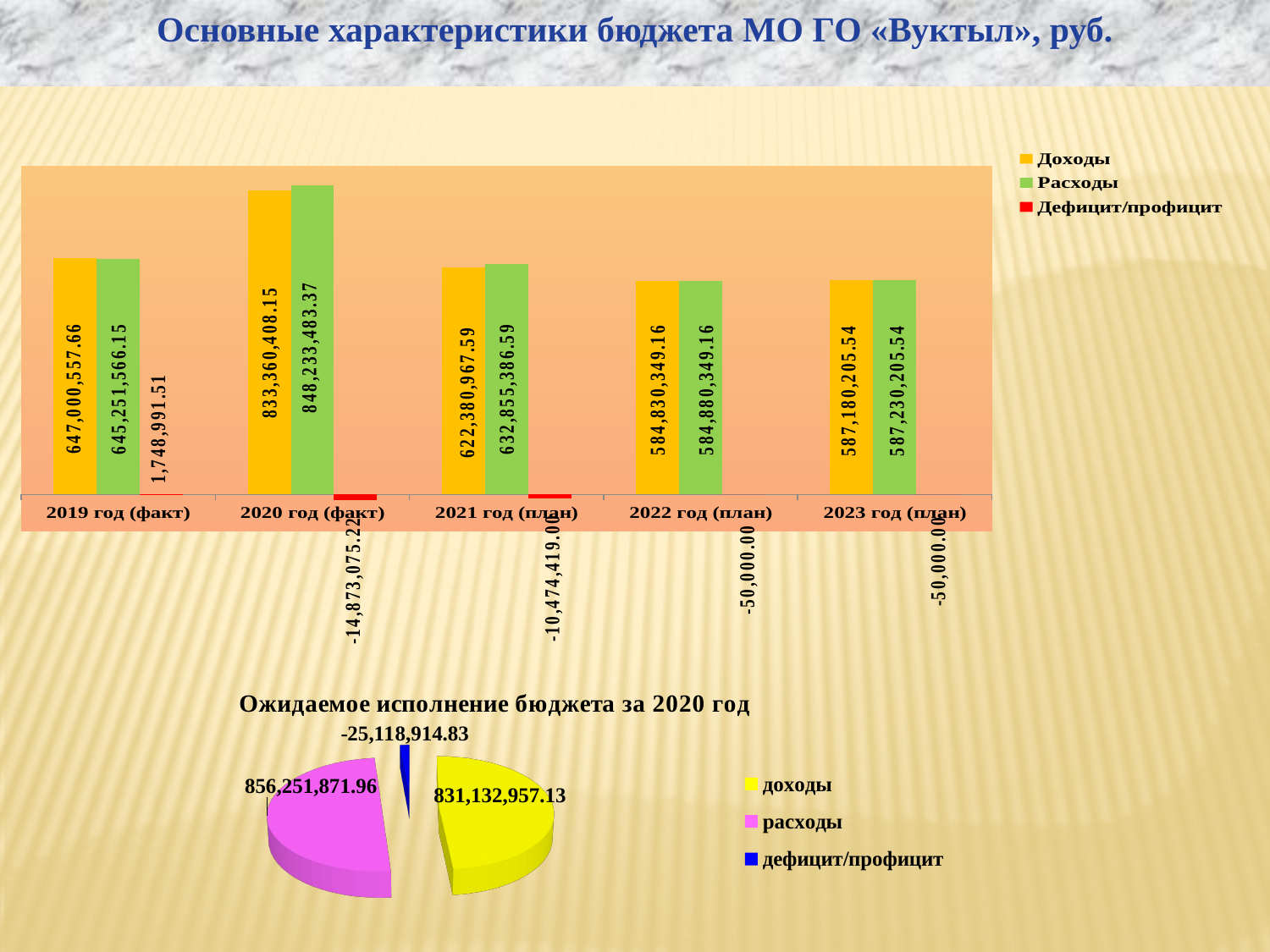
In the pie chart 'Ожидаемое исполнение бюджета за 2020 год', what colour represents доходы? Yellow In the top bar chart, what is the value of Расходы for 2021 год (план)? 632,855,386.59 How many series does the legend of the top bar chart list? 3 How many year categories are shown in the top bar chart? 5 In the top bar chart, which is larger for 2020 год (факт): Доходы or Расходы? Расходы In the top bar chart, which year has the highest Доходы? 2020 год (факт) In the top bar chart, what is the difference between Расходы and Доходы for 2022 год (план)? 50,000.00 In the top bar chart, what is the value of Доходы for 2020 год (факт)? 833,360,408.15 In the pie chart 'Ожидаемое исполнение бюджета за 2020 год', what is the value of расходы? 856,251,871.96 In the top bar chart, which year has the lowest Расходы? 2022 год (план) In the top bar chart, what is the value of Дефицит/профицит for 2019 год (факт)? 1,748,991.51 What kind of chart is the chart titled 'Ожидаемое исполнение бюджета за 2020 год'? Pie chart